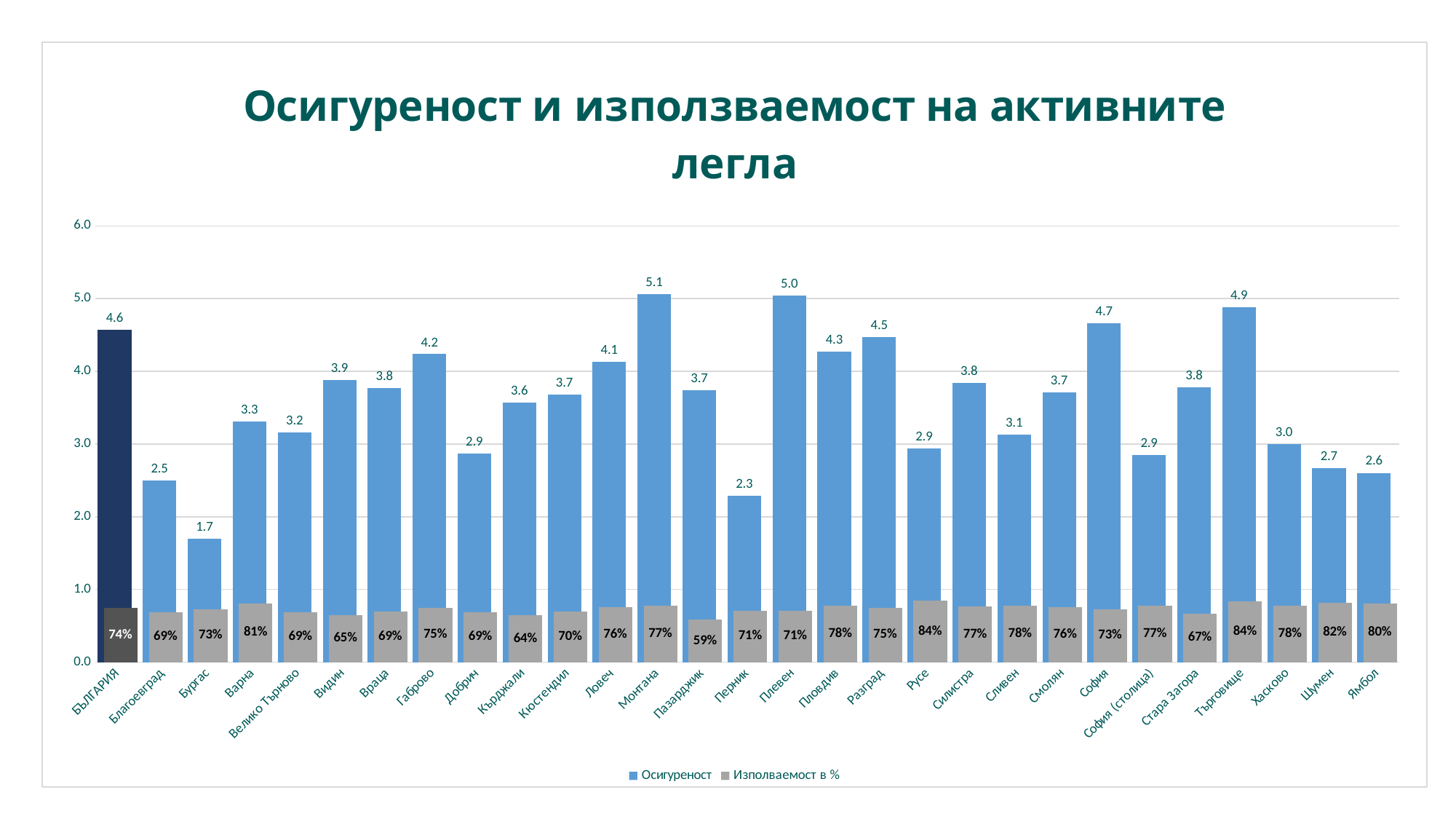
How many categories are shown on the x axis? 29 Which category has the highest Осигуреност value? Монтана What is the Осигуреност value for Монтана? 5.1 Which category has the lowest Използваемост в % value? Пазарджик Which category has the lowest Осигуреност value? Бургас What is the Осигуреност value for БЪЛГАРИЯ? 4.6 Which has a larger Осигуреност value, Пловдив or Русе? Пловдив Is the Осигуреност value for Търговище greater or less than 4.0? greater What is the Използваемост в % value for Пазарджик? 59% What is the difference between the Осигуреност values for Монтана and Бургас? 3.4 What kind of chart is shown on the slide? bar chart How many series does the legend list? 2